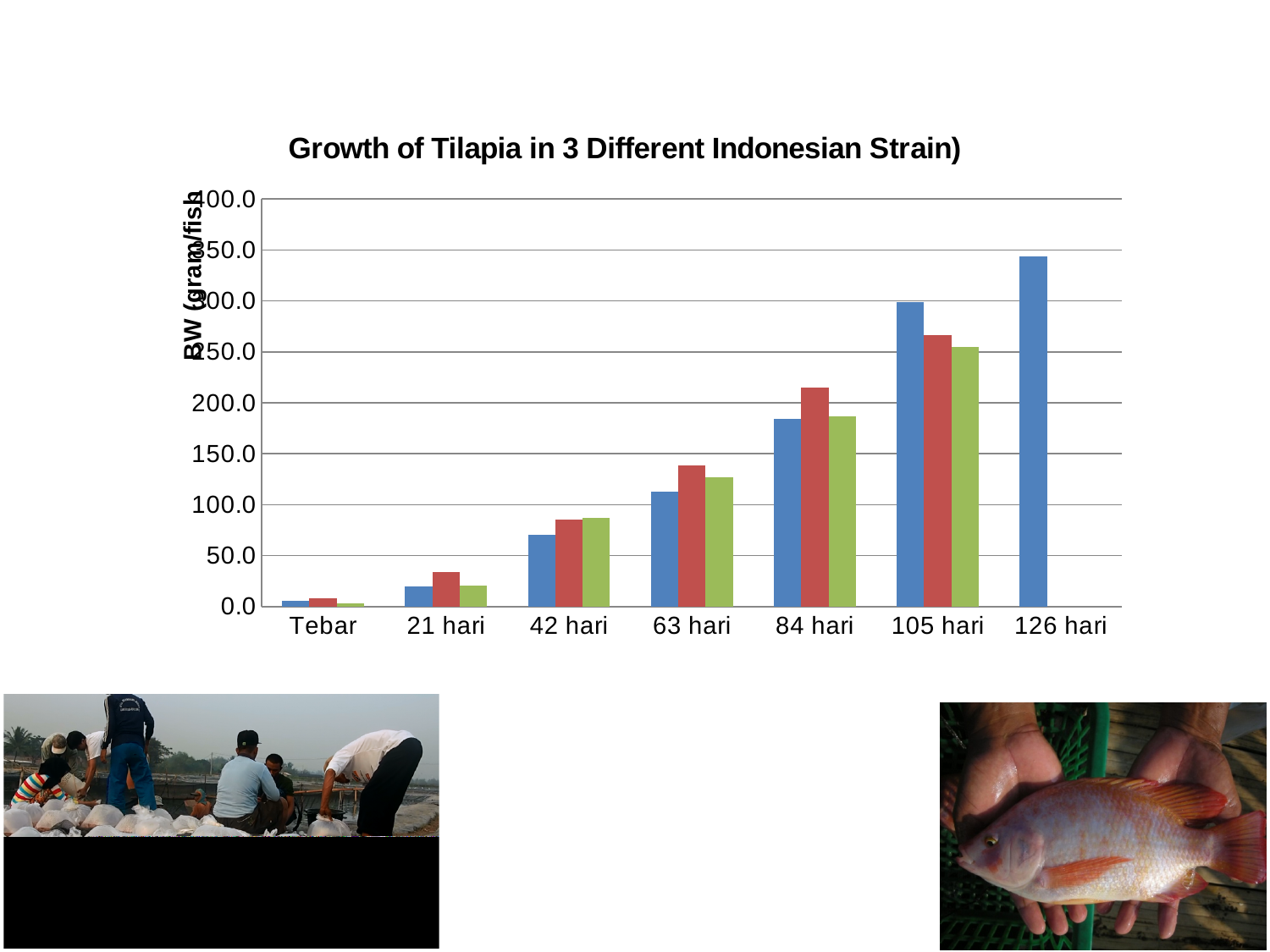
Is the value of the green bar at 84 hari greater or less than 200? less How many categories are shown on the x axis of the chart? 7 Is the value of the red bar at 105 hari greater or less than 250? greater Is the value of the red bar at 21 hari greater or less than 50? less What kind of chart is shown on the slide? bar chart What is the title of the chart? Growth of Tilapia in 3 Different Indonesian Strain) Do the values of the blue series rise or fall from Tebar to 126 hari? rise For the blue series, which category has the highest value? 126 hari At 84 hari, which is larger: the blue bar or the red bar? red bar At 42 hari, which is larger: the blue bar or the green bar? green bar What is the label of the y axis? BW (gram/fish)